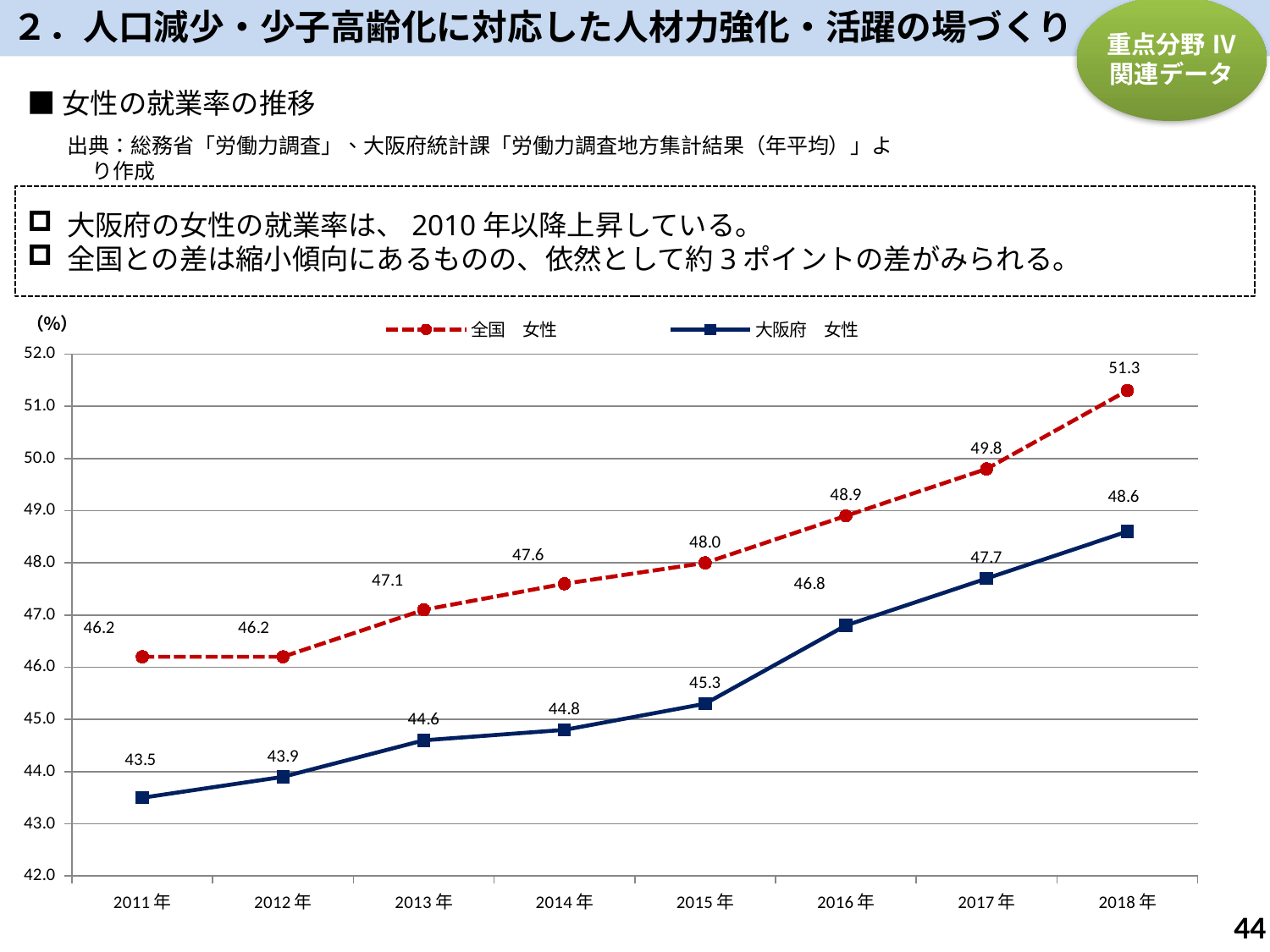
Which is larger in 2015年, 全国 女性 or 大阪府 女性? 全国 女性 What is the value for 大阪府 女性 in 2011年? 43.5 What is the difference between 全国 女性 and 大阪府 女性 in 2011年? 2.7 In which year is the 全国 女性 value lowest? 2011年 and 2012年 What is the value for 大阪府 女性 in 2016年? 46.8 What type of chart is shown on the slide? line chart What is the value for 全国 女性 in 2018年? 51.3 What is the difference between 全国 女性 and 大阪府 女性 in 2018年? 2.7 Does the 大阪府 女性 series rise or fall from 2011年 to 2018年? rise How many years are plotted on the x axis? 8 How many series does the legend list? 2 In which year is the 大阪府 女性 value highest? 2018年